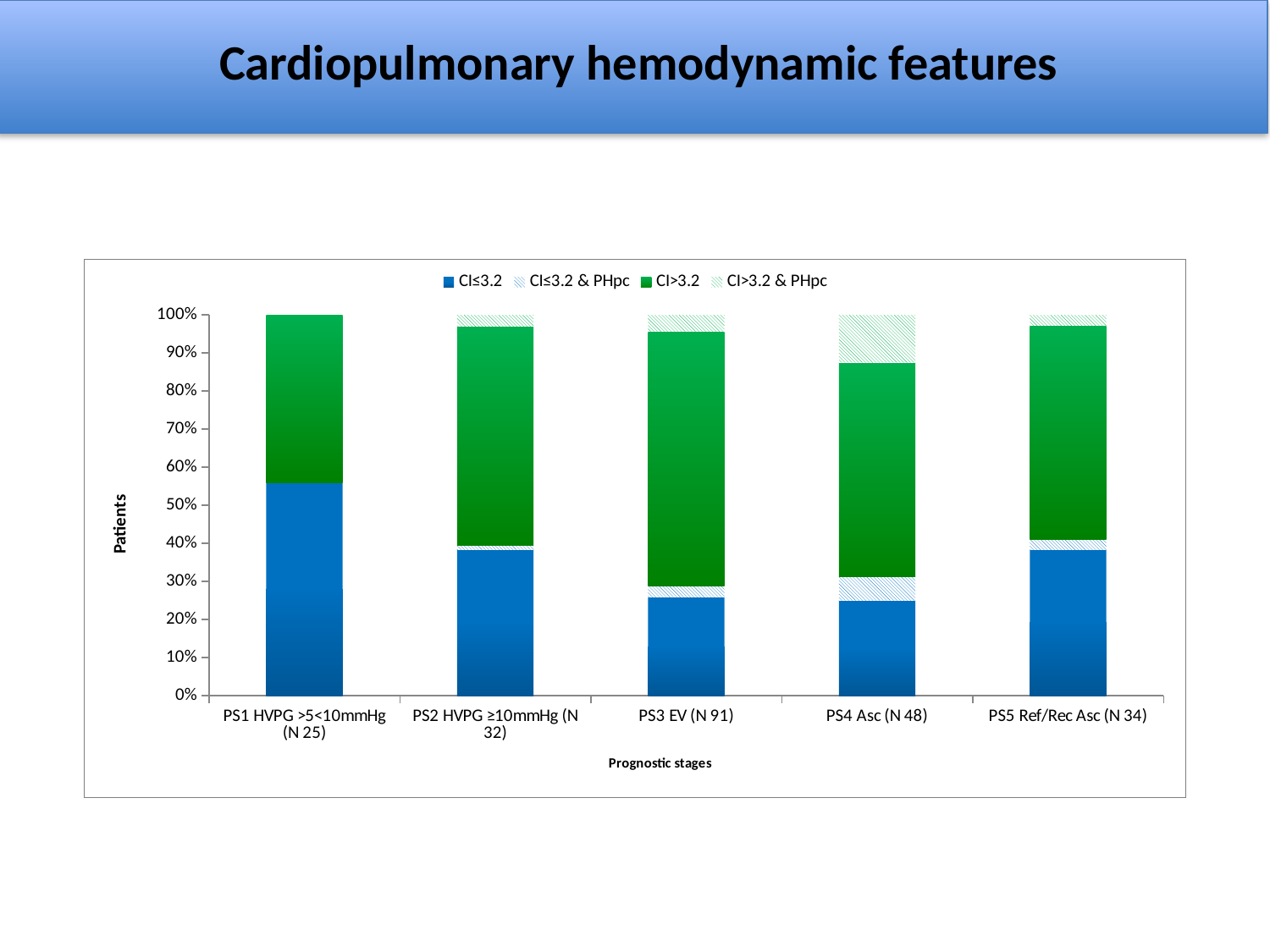
Is the CI≤3.2 share for PS5 Ref/Rec Asc (N 34) greater or less than 30%? greater Which has a larger CI>3.2 share, PS1 HVPG >5<10mmHg (N 25) or PS3 EV (N 91)? PS3 EV (N 91) Is the CI≤3.2 share for PS1 HVPG >5<10mmHg (N 25) greater or less than 50%? greater What is the title of the slide containing the chart? Cardiopulmonary hemodynamic features What kind of chart is shown on the slide? Stacked bar chart How many prognostic stage categories are shown on the x axis? 5 Is the CI≤3.2 share for PS3 EV (N 91) greater or less than 30%? less What is the total height of the PS1 HVPG >5<10mmHg (N 25) stacked bar? 100% Which has a larger CI≤3.2 share, PS1 HVPG >5<10mmHg (N 25) or PS4 Asc (N 48)? PS1 HVPG >5<10mmHg (N 25) What is the label of the y axis? Patients How many series does the legend list? 4 Which prognostic stage has the highest share of CI≤3.2 patients? PS1 HVPG >5<10mmHg (N 25)